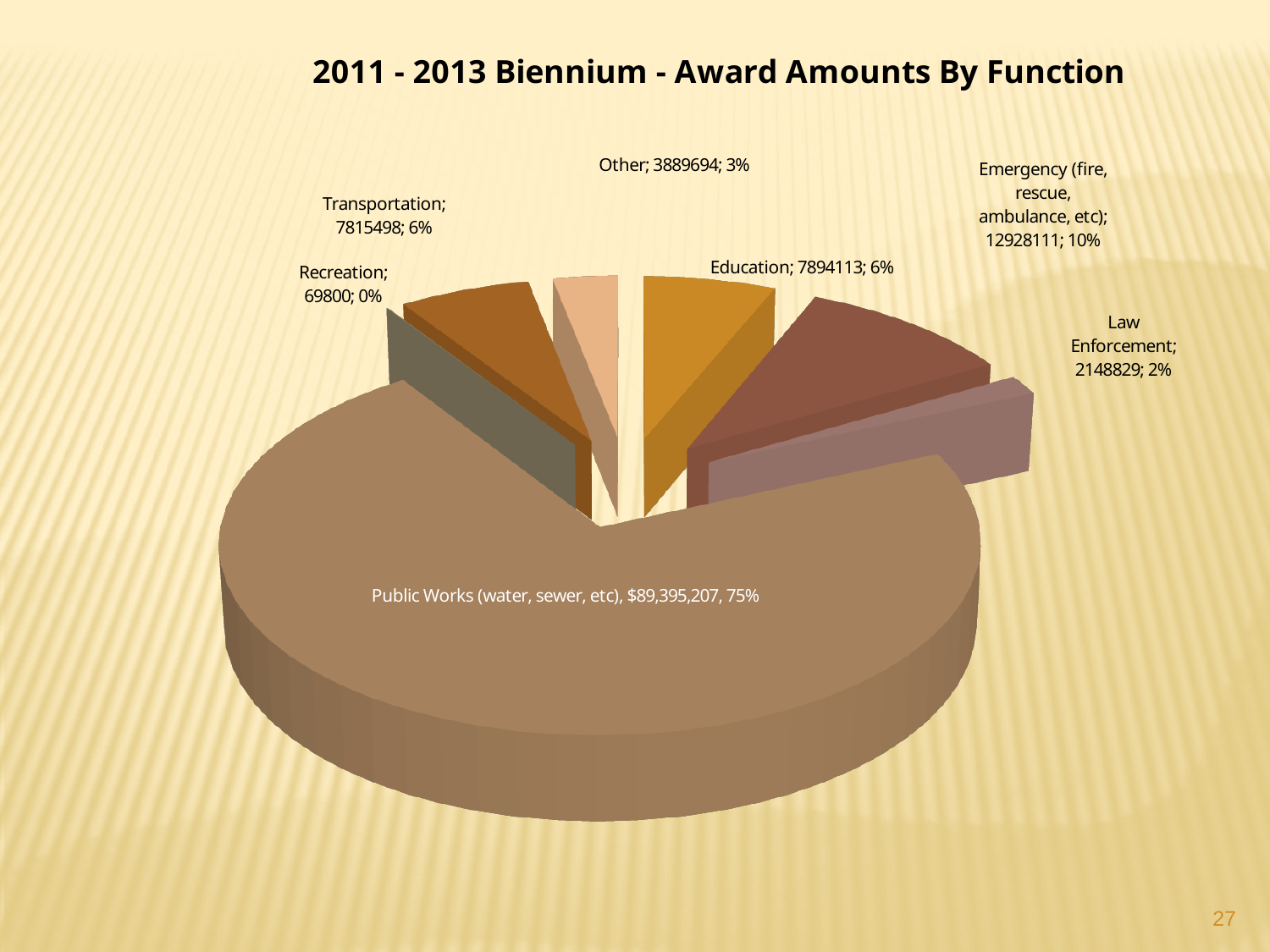
What is the award amount for Public Works (water, sewer, etc)? $89,395,207 What type of chart is shown on the slide? Pie chart What share of the pie does Law Enforcement represent? 2% Which has the larger award amount, Education or Transportation? Education Which function has the largest award amount? Public Works (water, sewer, etc) What is the award amount for Emergency (fire, rescue, ambulance, etc)? 12928111 Which function has the smallest award amount? Recreation What share of the pie does Emergency (fire, rescue, ambulance, etc) represent? 10% What is the difference between the award amounts for Emergency (fire, rescue, ambulance, etc) and Law Enforcement? 10779282 What is the award amount for Transportation? 7815498 What is the award amount for Education? 7894113 How many functions are shown in the pie chart? 7